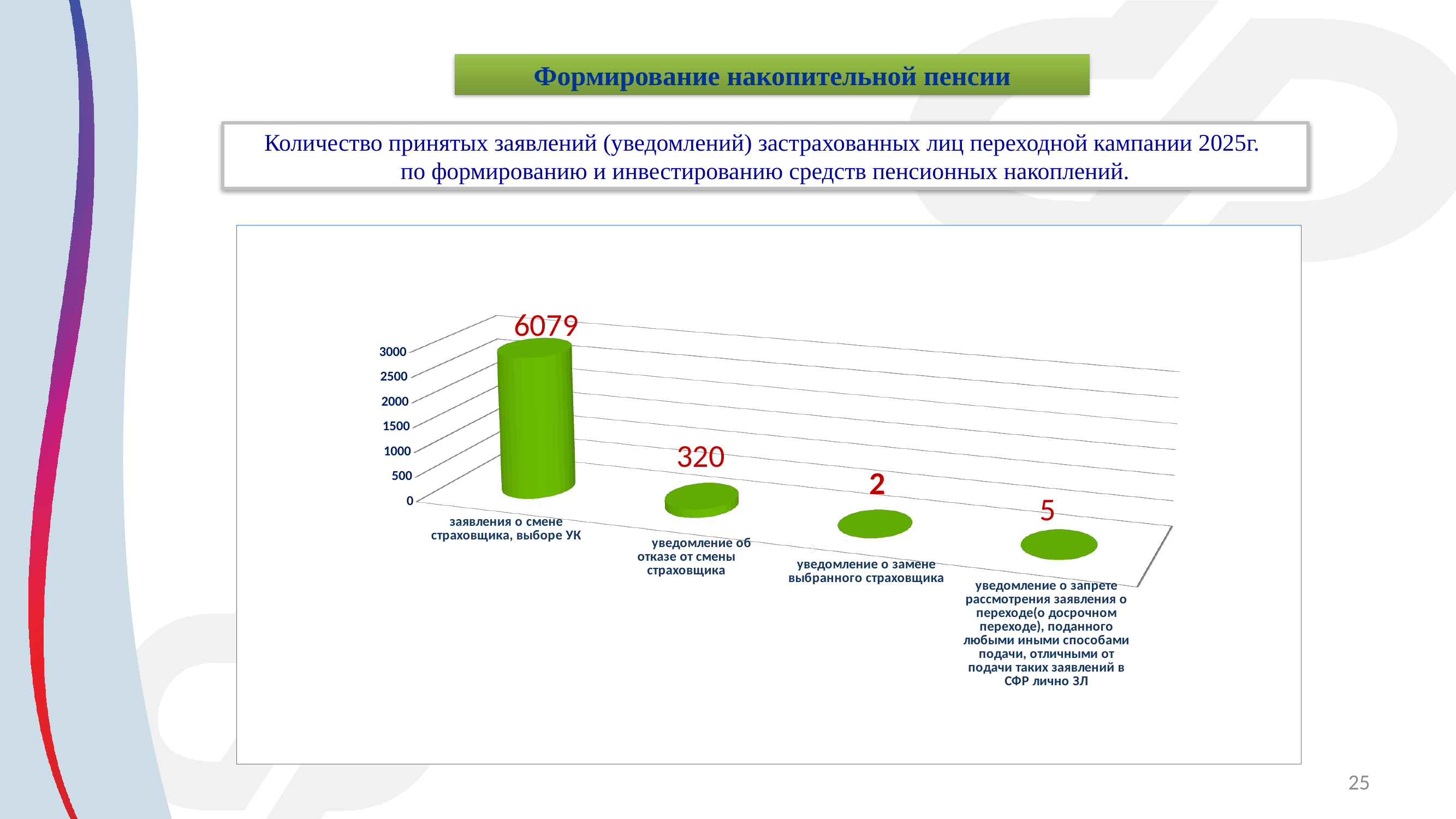
Which is larger: the value for "уведомление об отказе от смены страховщика" or the value for "уведомление о замене выбранного страховщика"? уведомление об отказе от смены страховщика Which category has the highest value? заявления о смене страховщика, выборе УК What is the value for "заявления о смене страховщика, выборе УК"? 6079 What kind of chart is shown on the slide? bar chart Is the value for "уведомление об отказе от смены страховщика" greater or less than 500? less Which category has the lowest value? уведомление о замене выбранного страховщика What is the value for "уведомление о запрете рассмотрения заявления о переходе(о досрочном переходе), поданного любыми иными способами подачи, отличными от подачи таких заявлений в СФР лично ЗЛ"? 5 What is the highest tick value shown on the vertical axis? 3000 What is the difference between the values for "заявления о смене страховщика, выборе УК" and "уведомление об отказе от смены страховщика"? 5759 How many categories are shown in the chart? 4 What is the value for "уведомление об отказе от смены страховщика"? 320 What is the value for "уведомление о замене выбранного страховщика"? 2